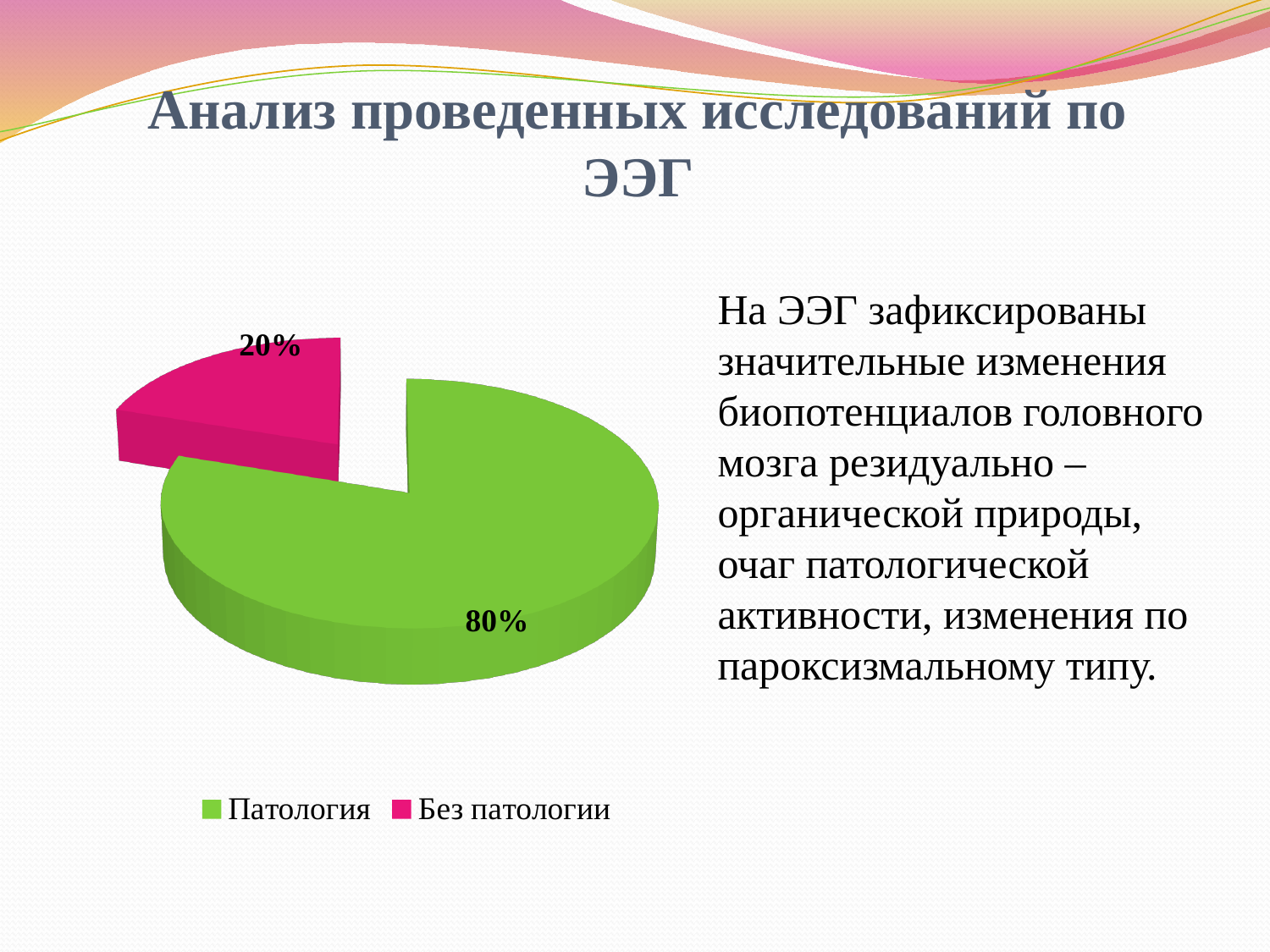
Which category has the smallest slice of the pie? Без патологии What kind of chart is shown on the slide? pie chart What share of the pie does Патология take? 80% How many slices does the pie chart have? 2 Which category has the largest slice of the pie? Патология Which is larger, the slice for Патология or the slice for Без патологии? Патология What share of the pie does Без патологии take? 20% What colour is the Без патологии slice? pink What is the difference in percentage points between the Патология slice and the Без патологии slice? 60% How many entries does the legend list? 2 What colour is the Патология slice? green